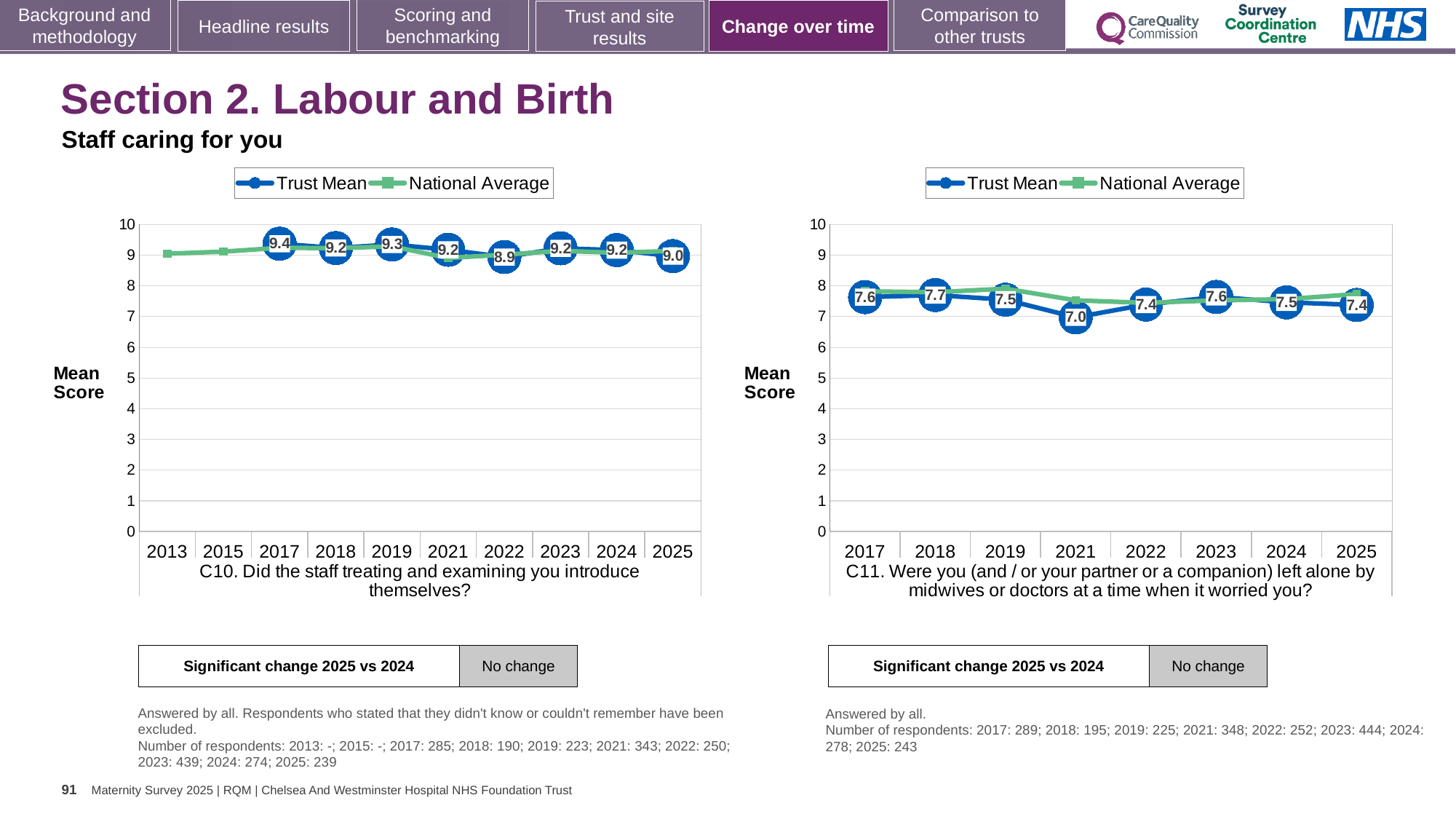
In the C10 chart (left), how many years are shown on the x axis? 10 In the C11 chart (right), what is the Trust Mean score for 2021? 7.0 In the C10 chart (left), which year has the lowest Trust Mean score? 2022 In the C10 chart (left), what is the Trust Mean score for 2017? 9.4 In the C11 chart (right), which year has the highest Trust Mean score? 2018 In the C11 chart (right), which year has the lowest Trust Mean score? 2021 What kind of chart is the C10 chart (left)? Line chart In the C11 chart (right), is the Trust Mean score for 2018 larger or smaller than for 2025? larger In the C10 chart (left), what is the difference between the Trust Mean scores for 2017 and 2022? 0.5 In the C10 chart (left), what is the Trust Mean score for 2025? 9.0 In the C11 chart (right), what is the difference between the Trust Mean scores for 2018 and 2021? 0.7 How many series does the legend of the C11 chart (right) list? 2